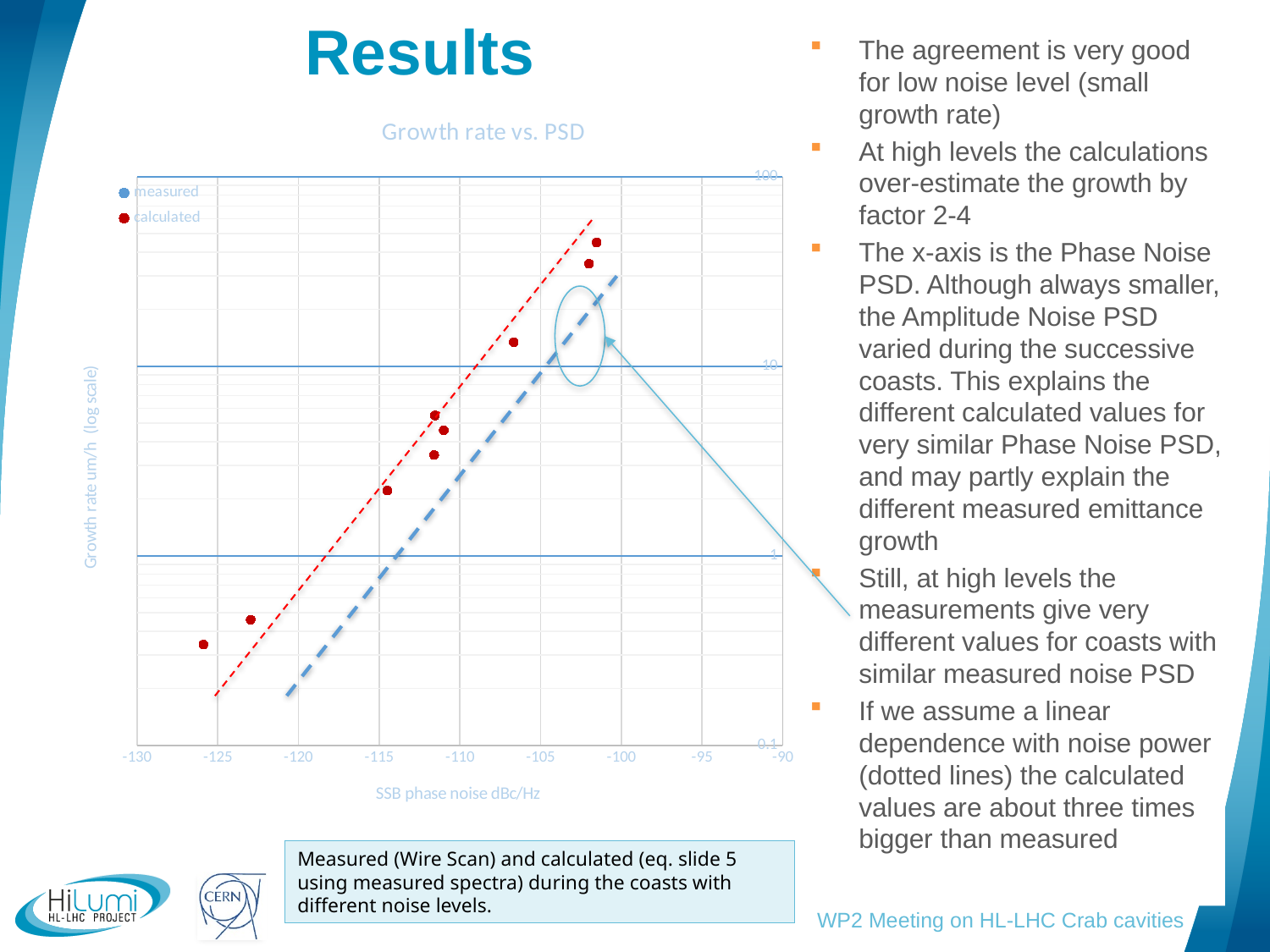
How many series does the legend of the 'Growth rate vs. PSD' chart list? 2 Is the calculated growth rate for the point near -126 dBc/Hz greater or less than 1? less What type of chart is shown on the slide? scatter chart What is the title of the chart? Growth rate vs. PSD Which colour marks the 'calculated' series in the chart legend? red What is the lowest value labelled on the y axis of the chart? 0.1 Is the calculated growth rate for the point near -106 dBc/Hz greater or less than 10? greater Is the highest calculated growth rate plotted greater or less than 100? less Do the calculated growth rate values rise or fall as the SSB phase noise increases from -130 to -90 dBc/Hz? rise Which calculated point has the higher growth rate: the one near -126 dBc/Hz or the one near -106 dBc/Hz? the one near -106 dBc/Hz